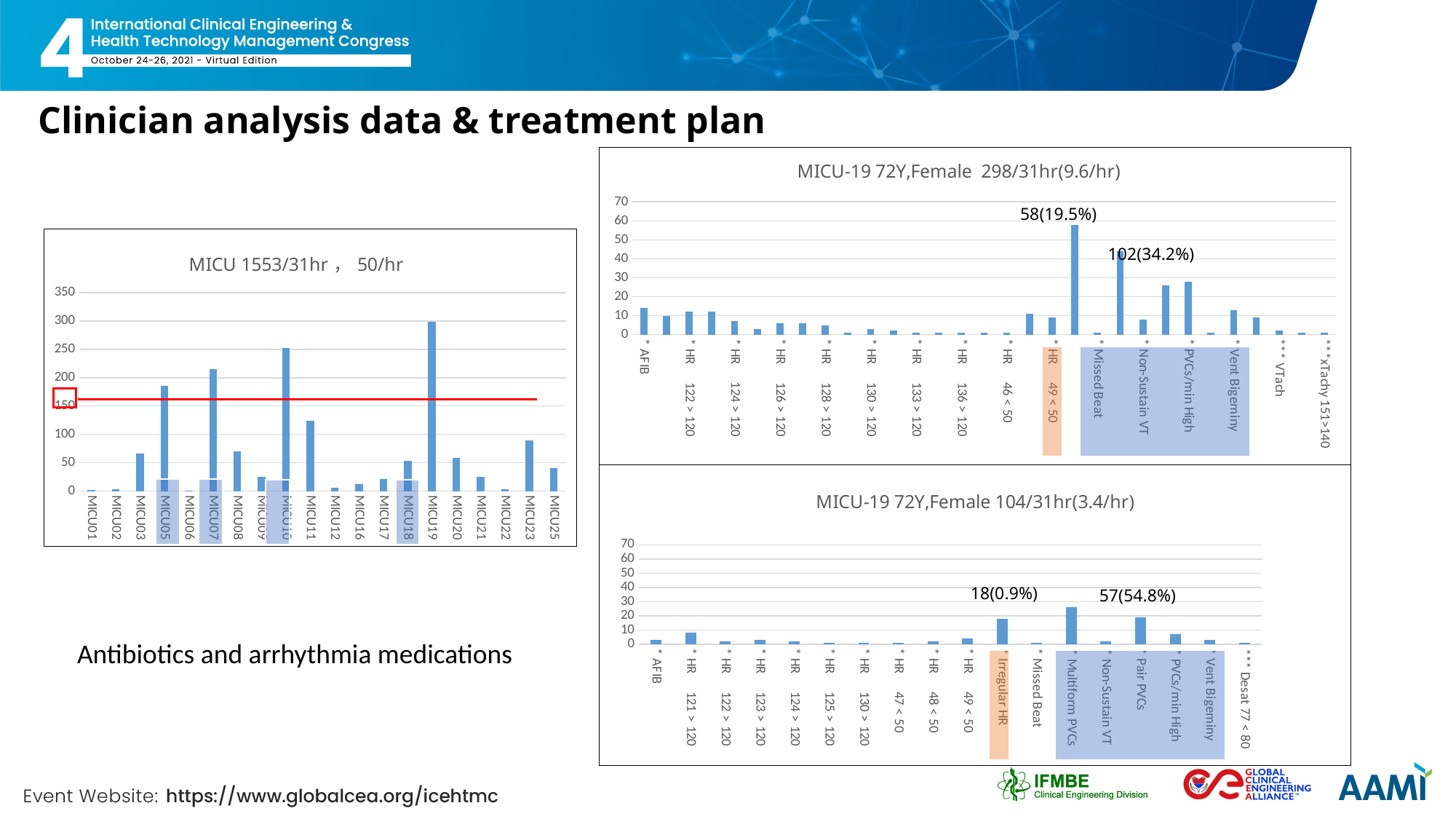
In the left chart titled "MICU 1553/31hr, 50/hr", is the value for MICU19 greater or less than 250? greater In the bottom right chart titled "MICU-19 72Y,Female 104/31hr(3.4/hr)", which category has the highest bar? Multiform PVCs What type of chart is the left chart titled "MICU 1553/31hr, 50/hr"? bar chart In the left chart titled "MICU 1553/31hr, 50/hr", how many MICU categories are shown on the x axis? 20 In the left chart titled "MICU 1553/31hr, 50/hr", which category has the highest bar? MICU19 In the bottom right chart titled "MICU-19 72Y,Female 104/31hr(3.4/hr)", what data label is shown above the bar for Irregular HR? 18(0.9%) In the left chart titled "MICU 1553/31hr, 50/hr", at what value is the horizontal red line drawn? 150 In the left chart titled "MICU 1553/31hr, 50/hr", is the value for MICU07 greater or less than 200? greater In the left chart titled "MICU 1553/31hr, 50/hr", is the value for MICU11 greater or less than 150? less In the left chart titled "MICU 1553/31hr, 50/hr", which is larger, the value for MICU05 or the value for MICU23? MICU05